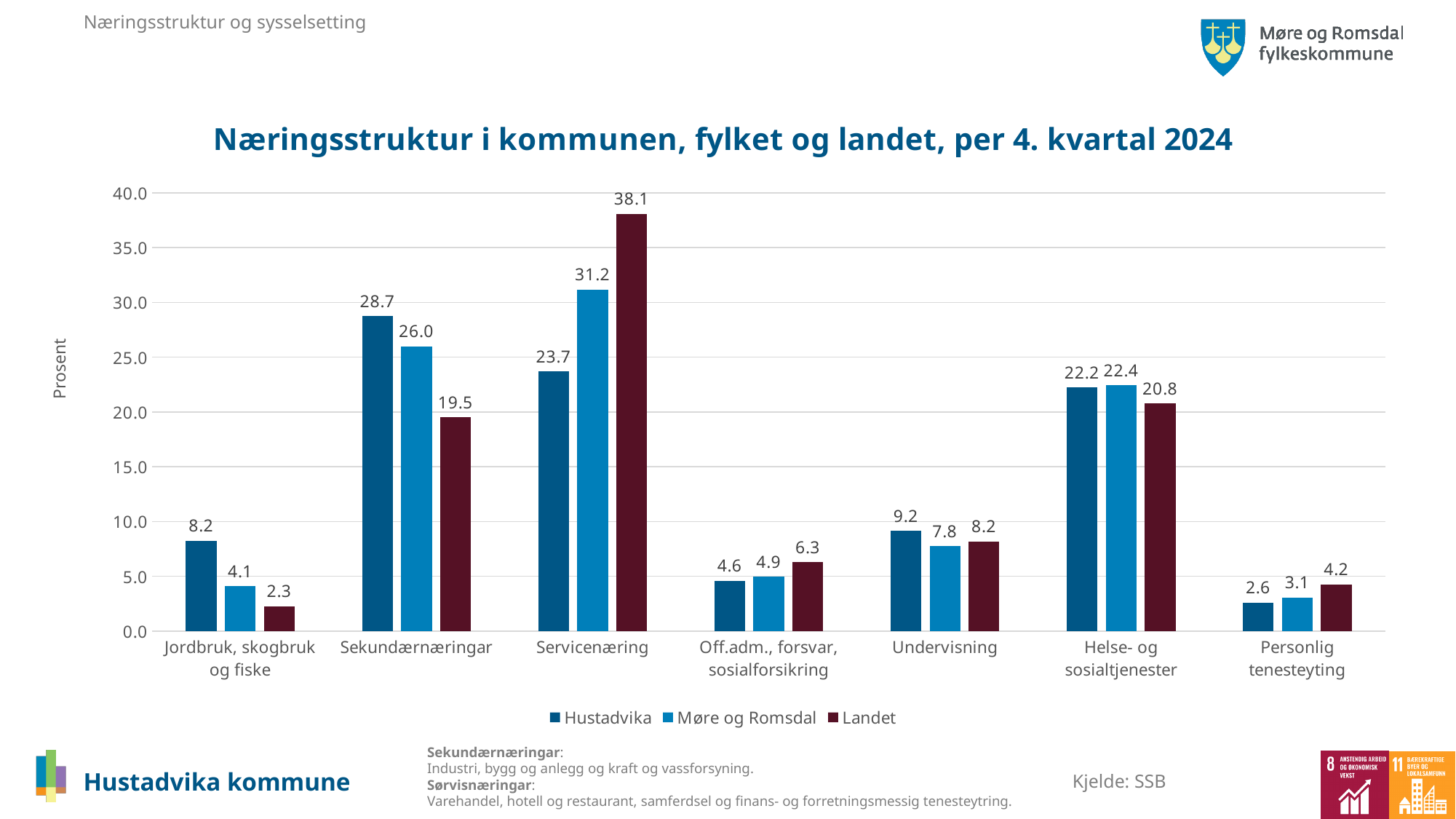
What is the difference between Landet and Hustadvika in Servicenæring? 14.4 What is the value for Møre og Romsdal in Undervisning? 7.8 How many series does the legend list? 3 What is the value for Hustadvika in Sekundærnæringar? 28.7 Which category has the lowest value for Hustadvika? Personlig tenesteyting Is the value for Møre og Romsdal in Sekundærnæringar greater or less than 25.0? greater Which is larger in Jordbruk, skogbruk og fiske: Hustadvika or Landet? Hustadvika What is the value for Landet in Servicenæring? 38.1 What is the label of the y axis? Prosent Which category has the highest value for Landet? Servicenæring What kind of chart is shown? bar chart How many categories are shown on the x axis? 7